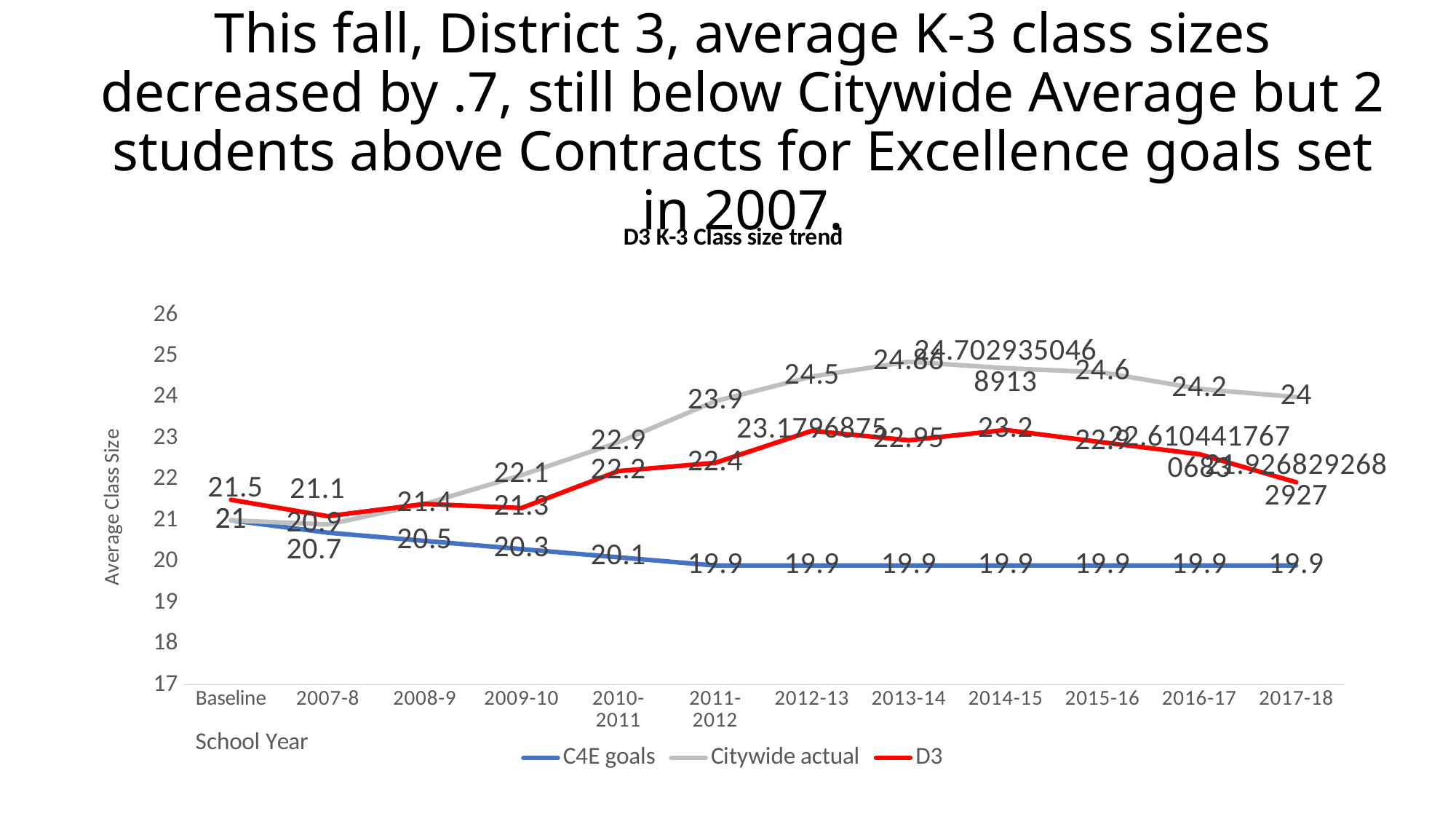
What is the Citywide actual value for 2017-18? 24 What kind of chart is shown on the slide? line chart How many school years are plotted along the x axis? 12 What is the D3 value at Baseline? 21.5 Does the Citywide actual series rise or fall from Baseline to 2012-13? rise In which school year is the C4E goals series highest? Baseline In 2011-2012, which is larger: Citywide actual or D3? Citywide actual What is the C4E goals value for 2017-18? 19.9 What is the difference between the Citywide actual and C4E goals values in 2017-18? 4.1 How many series does the legend list? 3 What is the lowest value of the C4E goals series? 19.9 What is the Citywide actual value for 2012-13? 24.5